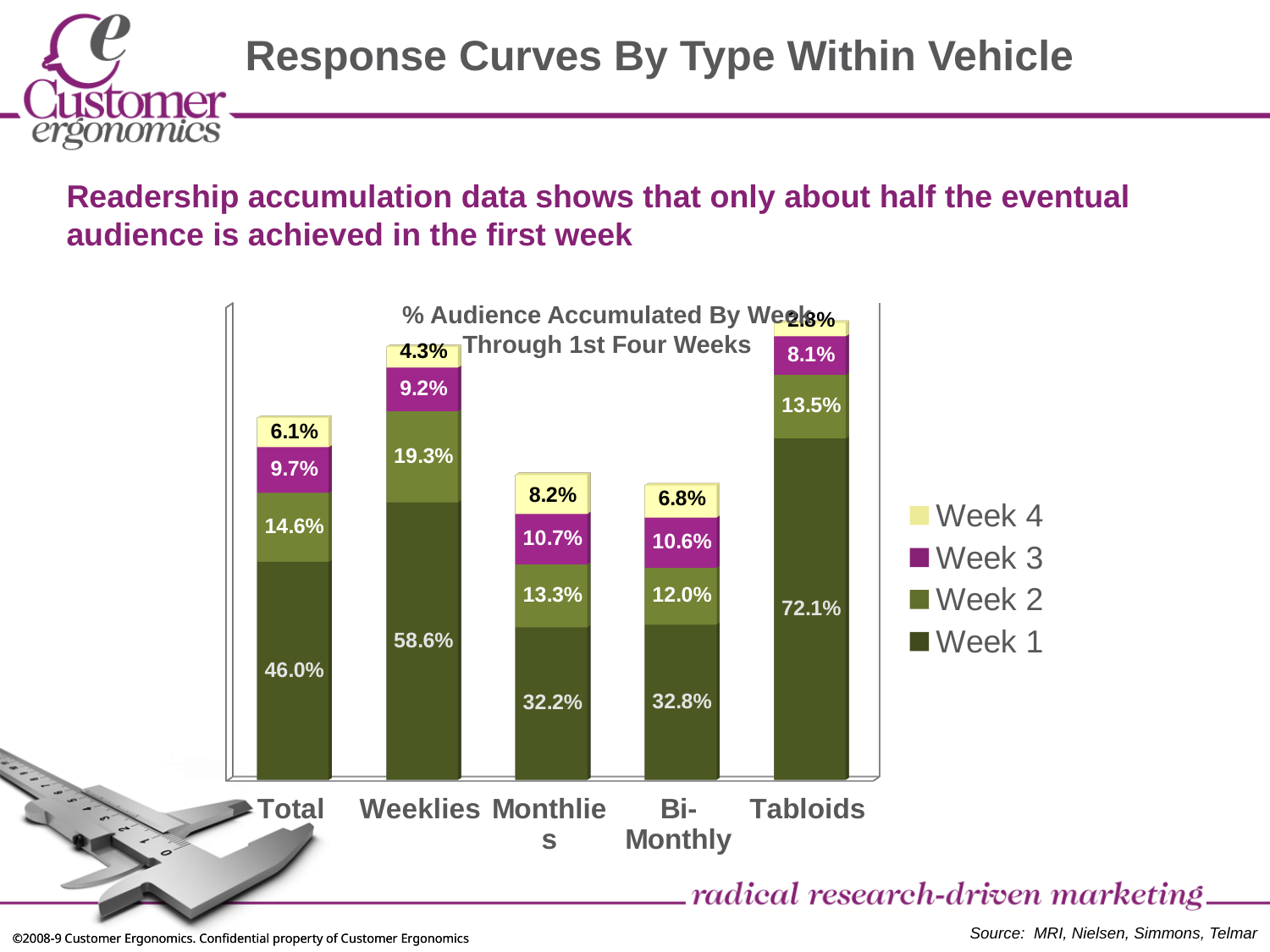
Which category has the lowest Week 2 value? Bi-Monthly Which is larger, the Week 4 value for Monthlies or for Bi-Monthly? Monthlies What is the difference between the Week 1 values for Weeklies and Total? 12.6% What is the Week 3 value for Monthlies? 10.7% What is the Week 4 value for Total? 6.1% How many series does the legend list? 4 What is the Week 2 value for Weeklies? 19.3% What kind of chart is shown on the slide? Stacked bar chart Which category has the highest Week 1 value? Tabloids What is the total of the stacked bar for Weeklies? 91.4% How many categories are shown on the x axis? 5 What is the Week 1 value for Tabloids? 72.1%